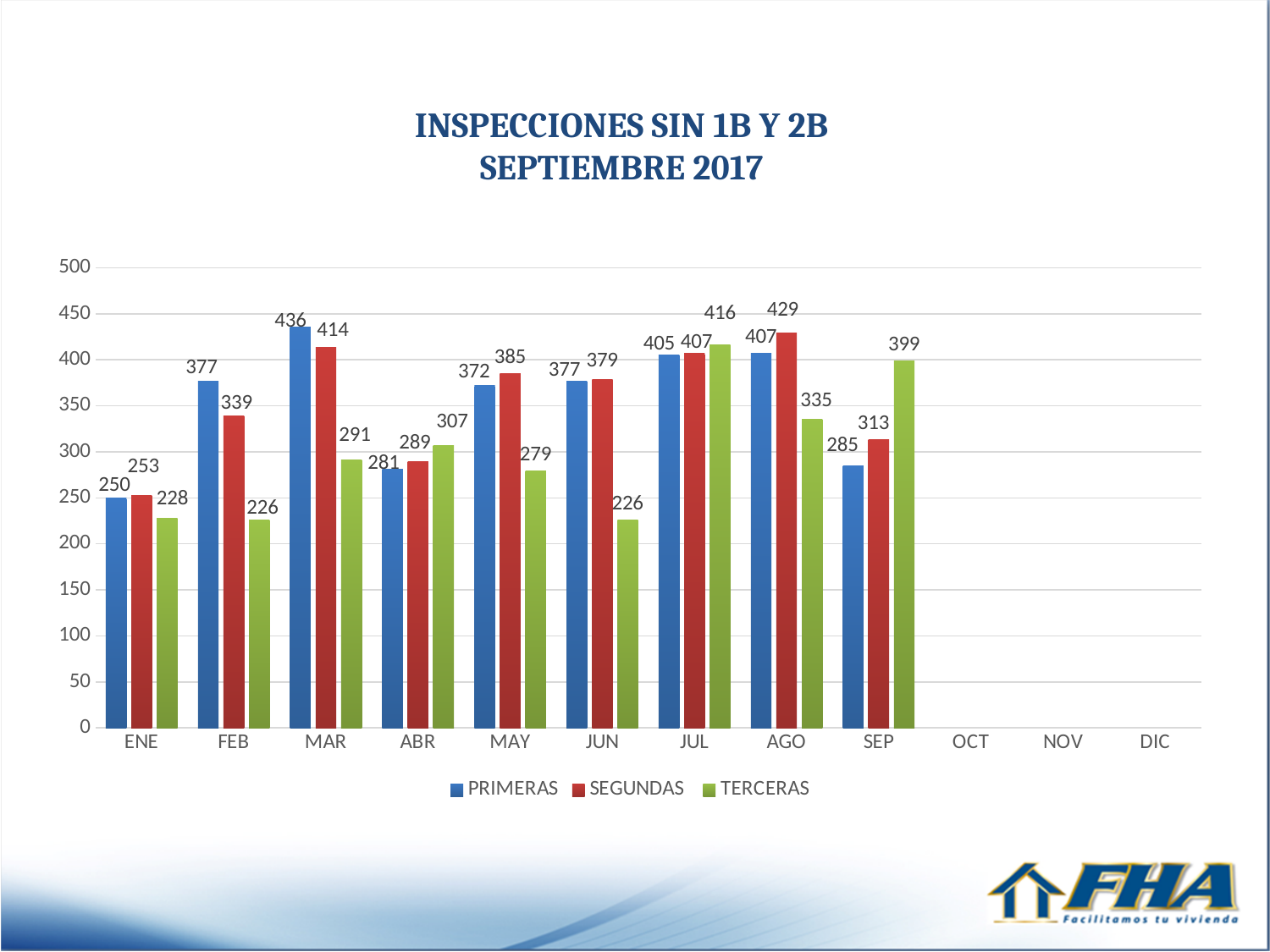
What is the value of TERCERAS in SEP? 399 Do the TERCERAS values rise or fall from ABR to JUN? Fall In JUL, which is larger: PRIMERAS or TERCERAS? TERCERAS In which month is the PRIMERAS value lowest? ENE What is the value of PRIMERAS in MAR? 436 What is the difference between PRIMERAS and SEGUNDAS in MAR? 22 How many months on the x axis have bars plotted? 9 How many series does the legend list? 3 In which month is the SEGUNDAS value highest? AGO What kind of chart is shown on the slide? Bar chart What is the difference between TERCERAS and PRIMERAS in SEP? 114 What is the value of SEGUNDAS in ABR? 289